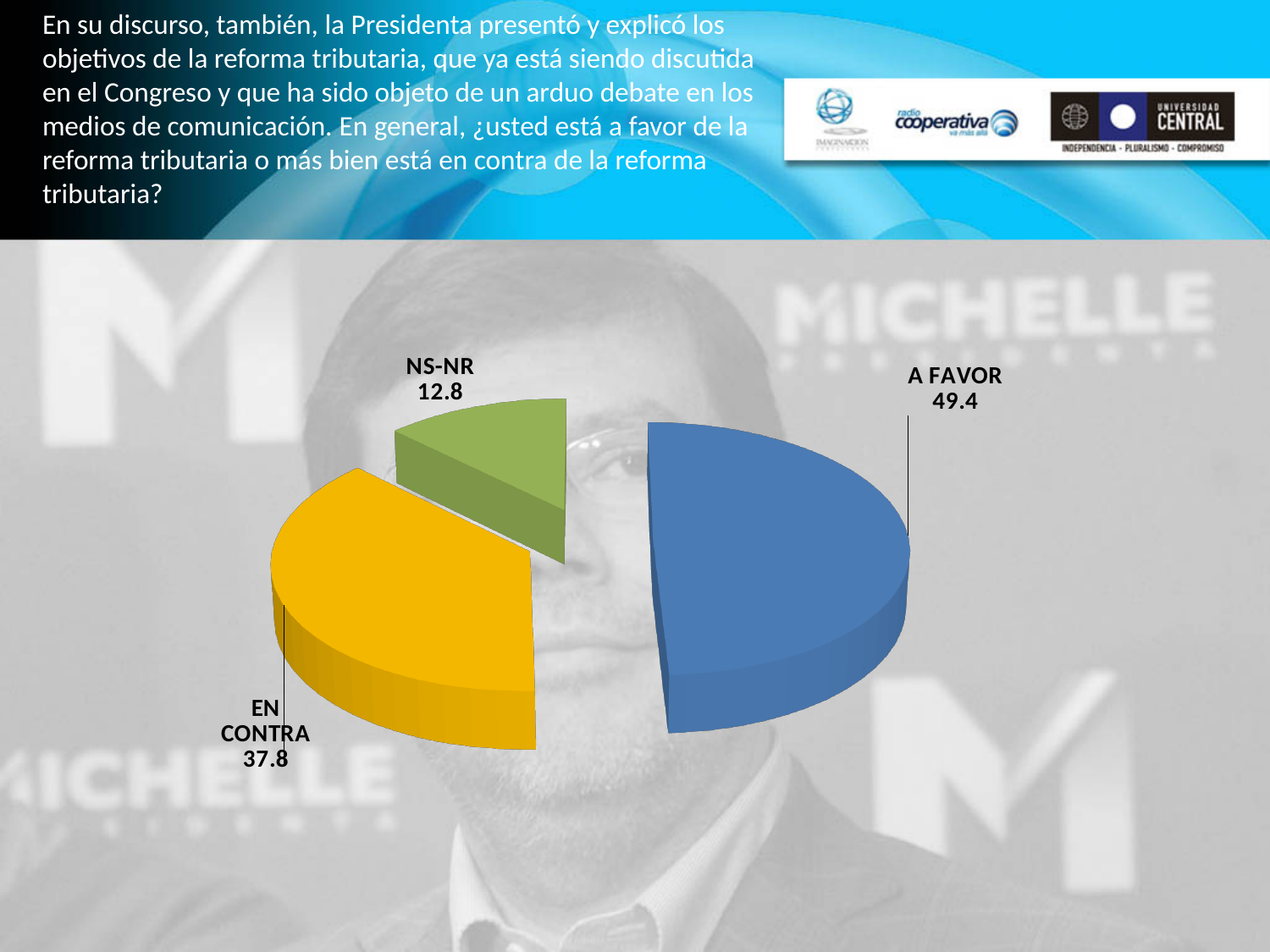
Which is larger, EN CONTRA or NS-NR? EN CONTRA What colour is the EN CONTRA slice? yellow What is the value for EN CONTRA? 37.8 What is the difference between the values for EN CONTRA and NS-NR? 25 What is the difference between the values for A FAVOR and EN CONTRA? 11.6 How many categories does the pie chart show? 3 What is the value for NS-NR? 12.8 What colour is the A FAVOR slice? blue Which category has the smallest slice? NS-NR Which category has the largest slice? A FAVOR What is the value for A FAVOR? 49.4 What kind of chart is shown on the slide? pie chart